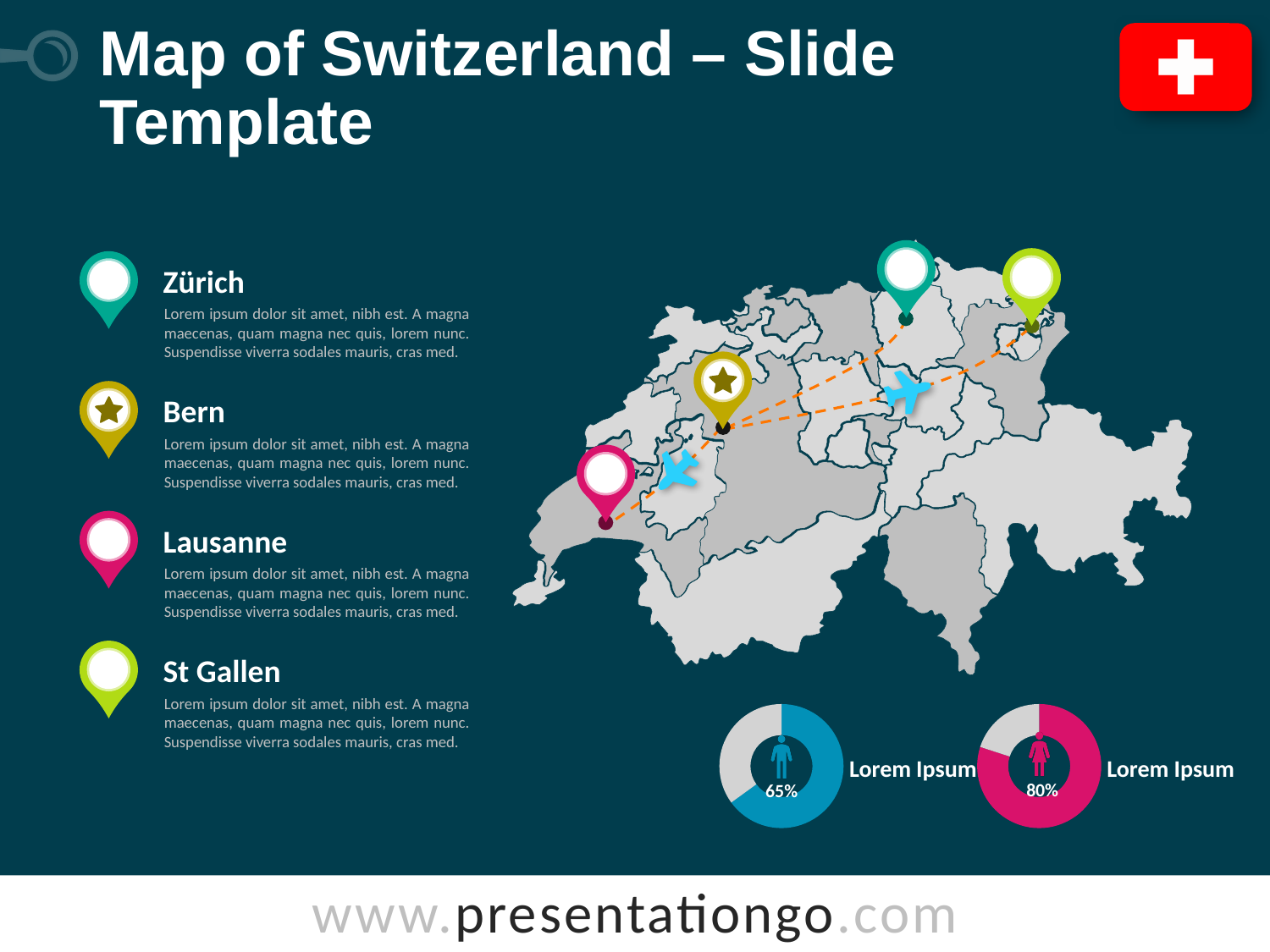
What value is shown in the right (pink) donut chart at the bottom of the slide? 80% How many donut charts are shown on the slide? 2 What icon is shown in the centre of the right (pink) donut chart? A female figure icon What label appears next to the left (blue) donut chart? Lorem Ipsum Is the value shown in the right (pink) donut chart greater or less than 75%? greater Which donut chart shows the larger value, the left (blue) one or the right (pink) one? The right (pink) one What value is shown in the left (blue) donut chart at the bottom of the slide? 65% Is the value shown in the left (blue) donut chart greater or less than 50%? greater What is the difference between the values shown in the right (pink) donut chart and the left (blue) donut chart? 15% What kind of charts are the two small charts at the bottom right of the slide? Donut charts